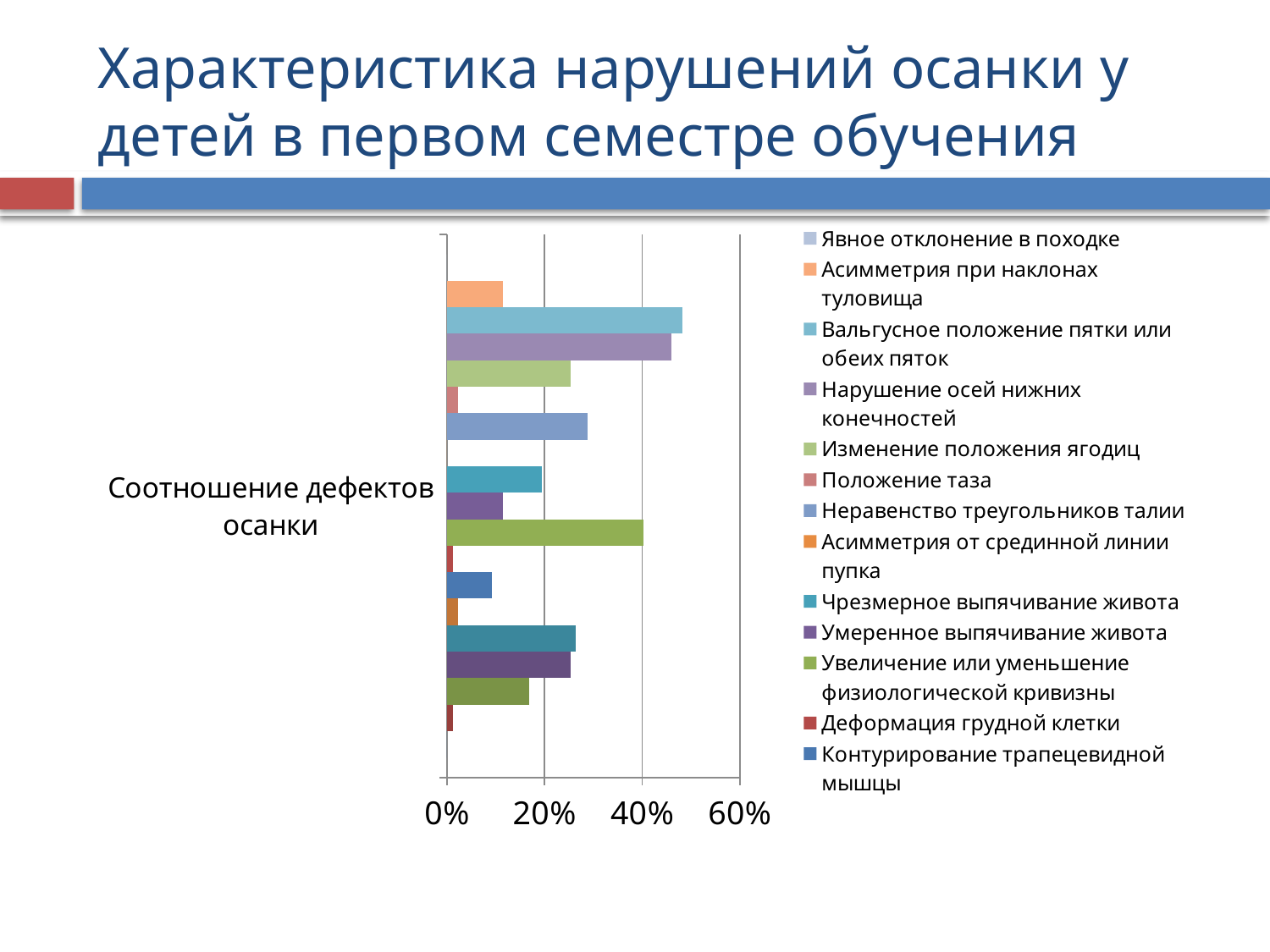
Is the longest bar in the chart greater or less than 40%? greater Is the longest bar in the chart greater or less than 60%? less What kind of chart is shown on the slide? bar chart Is the shortest bar in the chart greater or less than 20%? less How many series does the legend list? 13 Which legend entry is listed first in the chart's legend? Явное отклонение в походке How many categories are shown on the vertical axis of the chart? 1 What is the category label shown on the vertical axis of the chart? Соотношение дефектов осанки What is the highest value shown on the horizontal axis of the chart? 60%